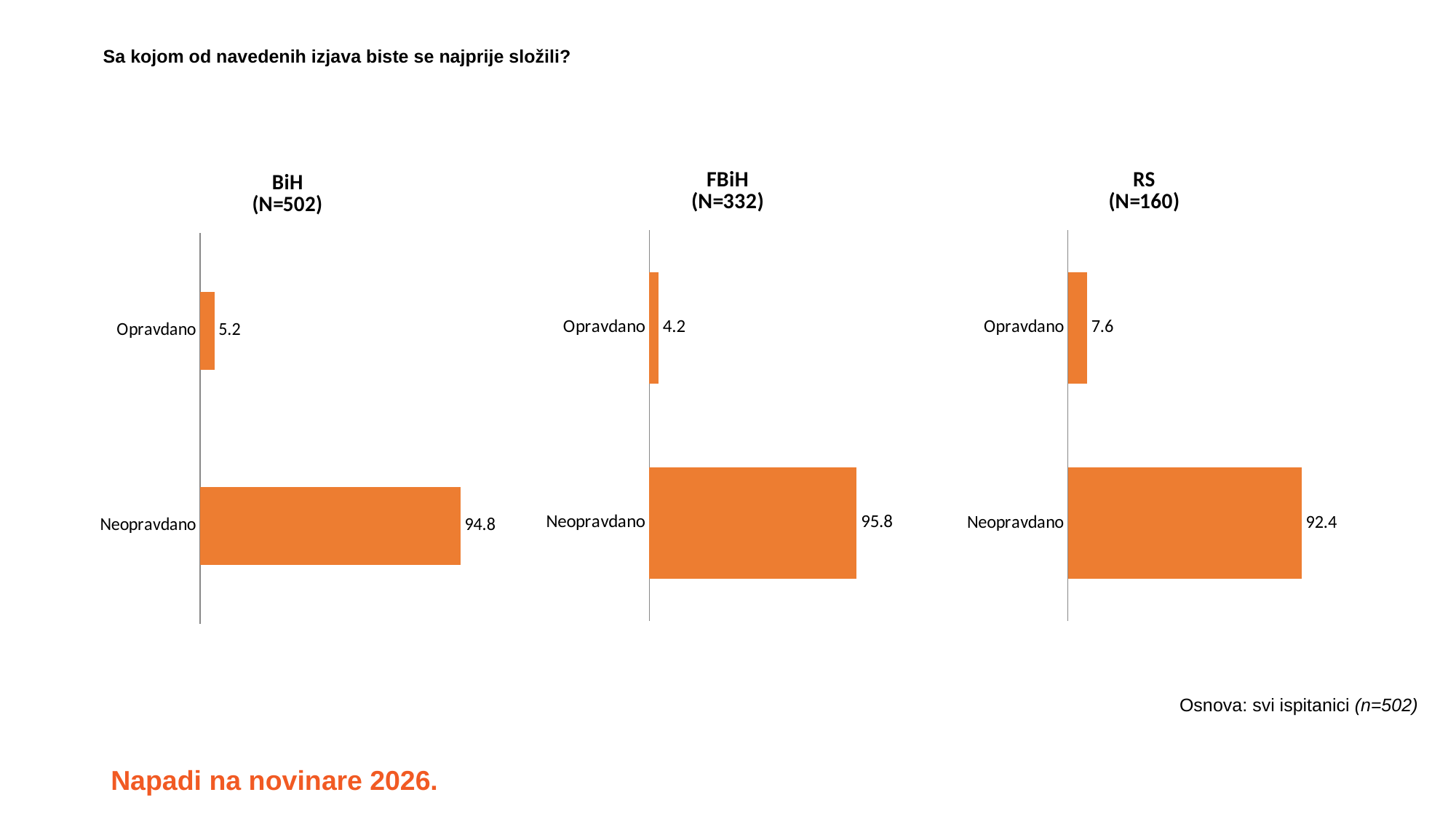
In the BiH (N=502) chart, what is the difference between the Neopravdano and Opravdano values? 89.6 In the FBiH (N=332) chart, which category has the lowest value? Opravdano In the FBiH (N=332) chart, what is the value for Neopravdano? 95.8 How many categories does the BiH (N=502) chart show? 2 In the RS (N=160) chart, what is the value for Opravdano? 7.6 In the RS (N=160) chart, what is the value for Neopravdano? 92.4 Is the Opravdano value larger in the RS (N=160) chart or in the FBiH (N=332) chart? RS (N=160) In the RS (N=160) chart, which category has the highest value? Neopravdano In the BiH (N=502) chart, what is the value for Opravdano? 5.2 In the FBiH (N=332) chart, what is the value for Opravdano? 4.2 In the BiH (N=502) chart, what is the value for Neopravdano? 94.8 What type of chart is the FBiH (N=332) chart? Bar chart